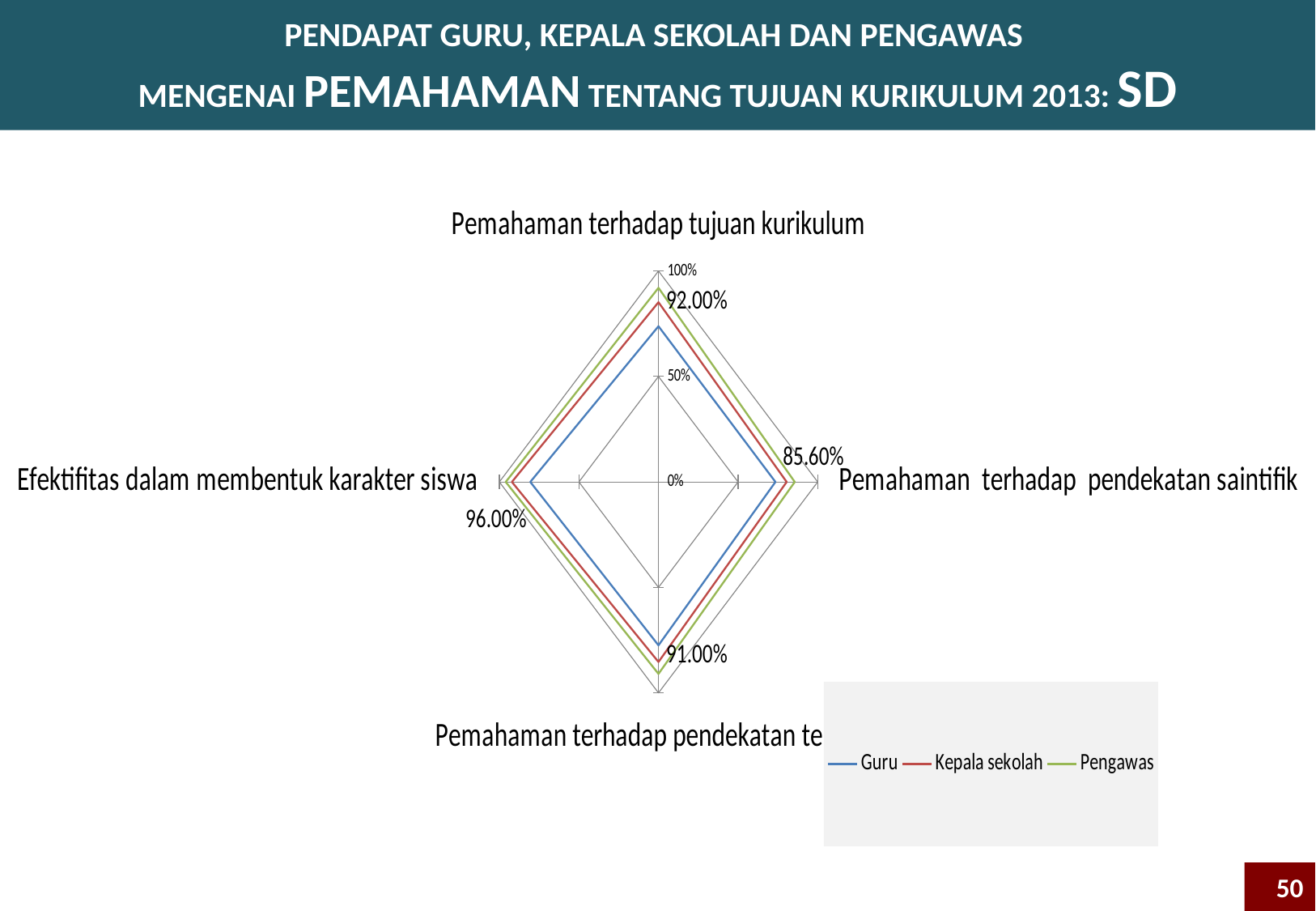
Which colour represents the 'Kepala sekolah' series in the legend? red Which series has the highest value on the 'Pemahaman terhadap tujuan kurikulum' axis? Pengawas What kind of chart is shown on the slide? radar chart How many axes (categories) does the radar chart have? 4 Is the value for Guru on the 'Pemahaman terhadap pendekatan saintifik' axis greater or less than 50%? greater How many series does the legend list? 3 What value is labelled on the 'Pemahaman terhadap tujuan kurikulum' axis? 92.00% What value is labelled on the 'Efektifitas dalam membentuk karakter siswa' axis? 96.00% Which series has the lowest value on the 'Efektifitas dalam membentuk karakter siswa' axis? Guru What value is labelled on the bottom axis of the radar chart? 91.00% Which is larger on the 'Efektifitas dalam membentuk karakter siswa' axis, Pengawas or Guru? Pengawas What value is labelled on the 'Pemahaman terhadap pendekatan saintifik' axis? 85.60%